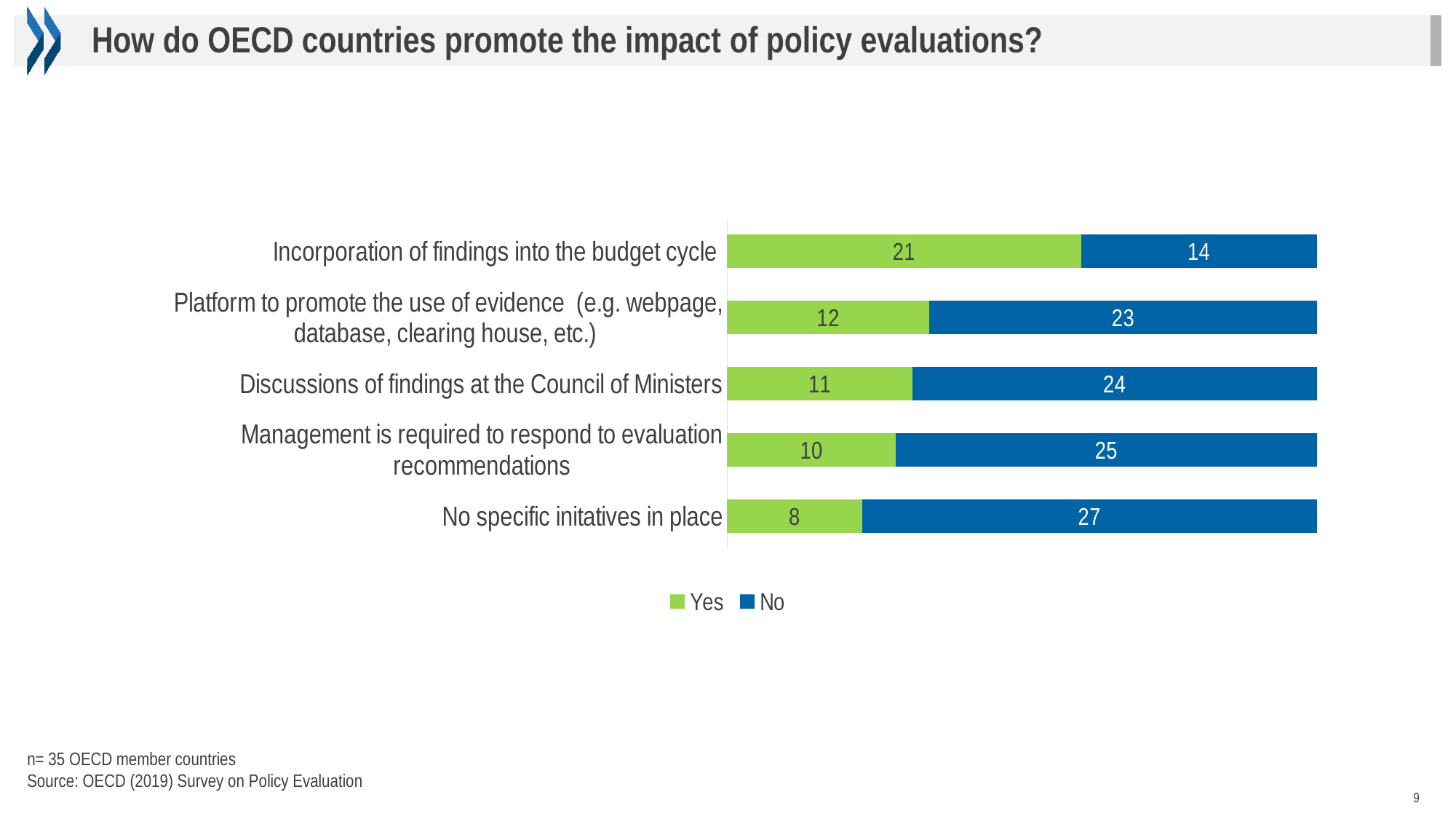
How many series does the legend list? 2 What is the total of the stacked bar for 'Discussions of findings at the Council of Ministers'? 35 What is the 'Yes' value for 'No specific initatives in place'? 8 Which is larger for 'Platform to promote the use of evidence (e.g. webpage, database, clearing house, etc.)': the 'Yes' value or the 'No' value? No What is the difference between the 'No' and 'Yes' values for 'Management is required to respond to evaluation recommendations'? 15 Which category has the highest 'Yes' value? Incorporation of findings into the budget cycle What is the 'Yes' value for 'Incorporation of findings into the budget cycle'? 21 Which category has the lowest 'Yes' value? No specific initatives in place How many categories are shown in the chart? 5 Which category has the highest 'No' value? No specific initatives in place What kind of chart is shown on the slide? Stacked bar chart What is the 'No' value for 'Discussions of findings at the Council of Ministers'? 24